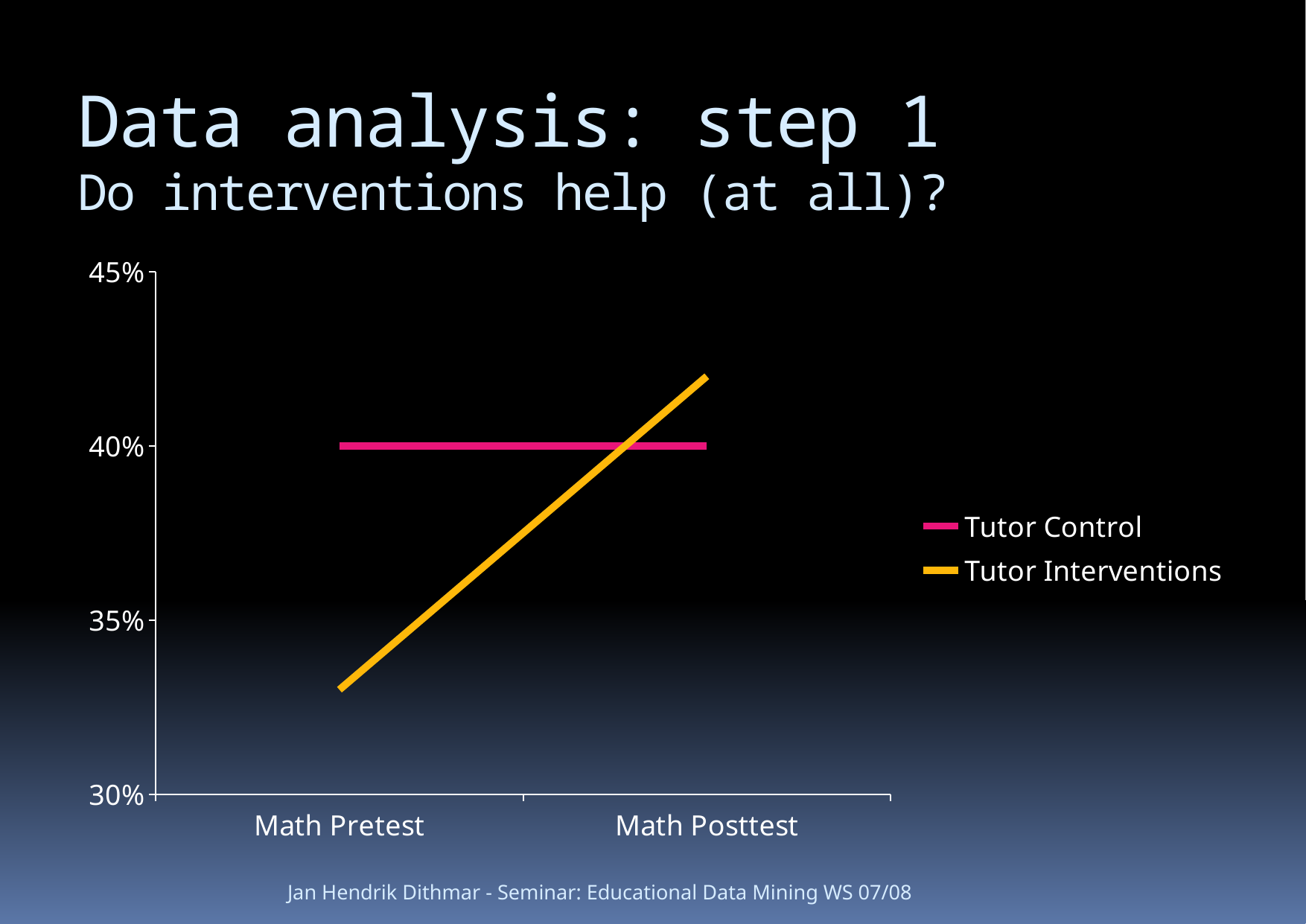
What kind of chart is shown on the slide? line chart What is the value for Tutor Control at Math Pretest? 40% Is the value for Tutor Interventions at Math Pretest greater or less than 35%? less What is the value for Tutor Control at Math Posttest? 40% Which series is drawn in orange? Tutor Interventions How many categories are shown on the x axis? 2 Does the Tutor Interventions line rise or fall from Math Pretest to Math Posttest? rise Which series has the higher value at Math Pretest, Tutor Control or Tutor Interventions? Tutor Control What are the two category labels on the x axis? Math Pretest, Math Posttest Is the value for Tutor Interventions at Math Posttest greater or less than 40%? greater How many series does the legend list? 2 Which series has the higher value at Math Posttest, Tutor Control or Tutor Interventions? Tutor Interventions